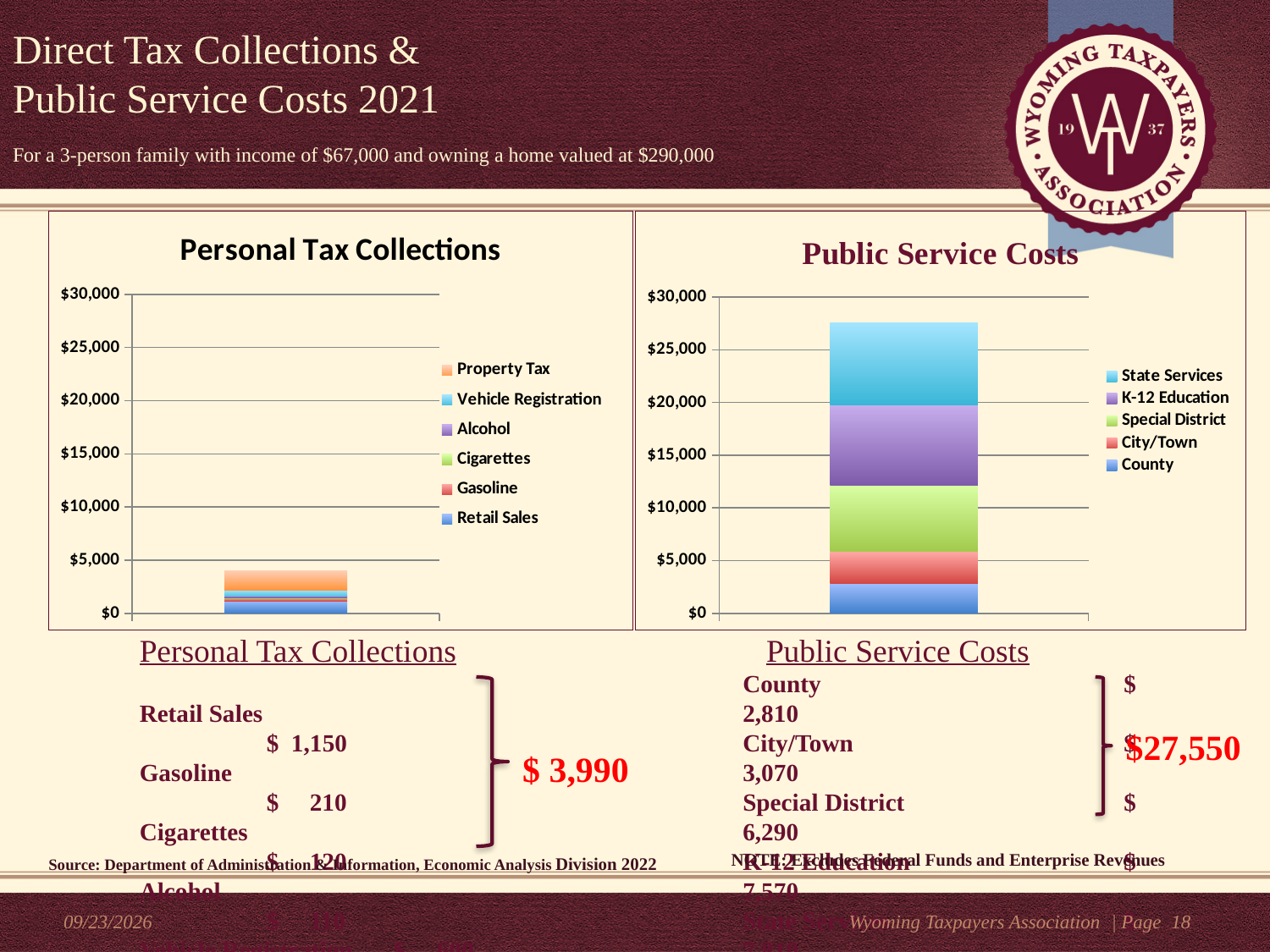
What is the total of the Personal Tax Collections stacked bar, as printed on the slide? $ 3,990 In the Personal Tax Collections chart, is the total height of the stacked bar greater or less than $5,000? less In the Public Service Costs chart, which series is shown at the top of the stacked bar according to the legend? State Services What kind of chart is the Public Service Costs chart? Stacked bar chart In the Personal Tax Collections chart, which series is listed first in the legend? Property Tax In the Public Service Costs chart, which segment is larger: Special District or County? Special District How many series does the legend of the Public Service Costs chart list? 5 In the Public Service Costs chart, is the total height of the stacked bar greater or less than $25,000? greater What kind of chart is the Personal Tax Collections chart? Stacked bar chart What is the total of the Public Service Costs stacked bar, as printed on the slide? $27,550 In the Public Service Costs chart, is the Special District segment greater or less than $5,000? greater How many series does the legend of the Personal Tax Collections chart list? 6